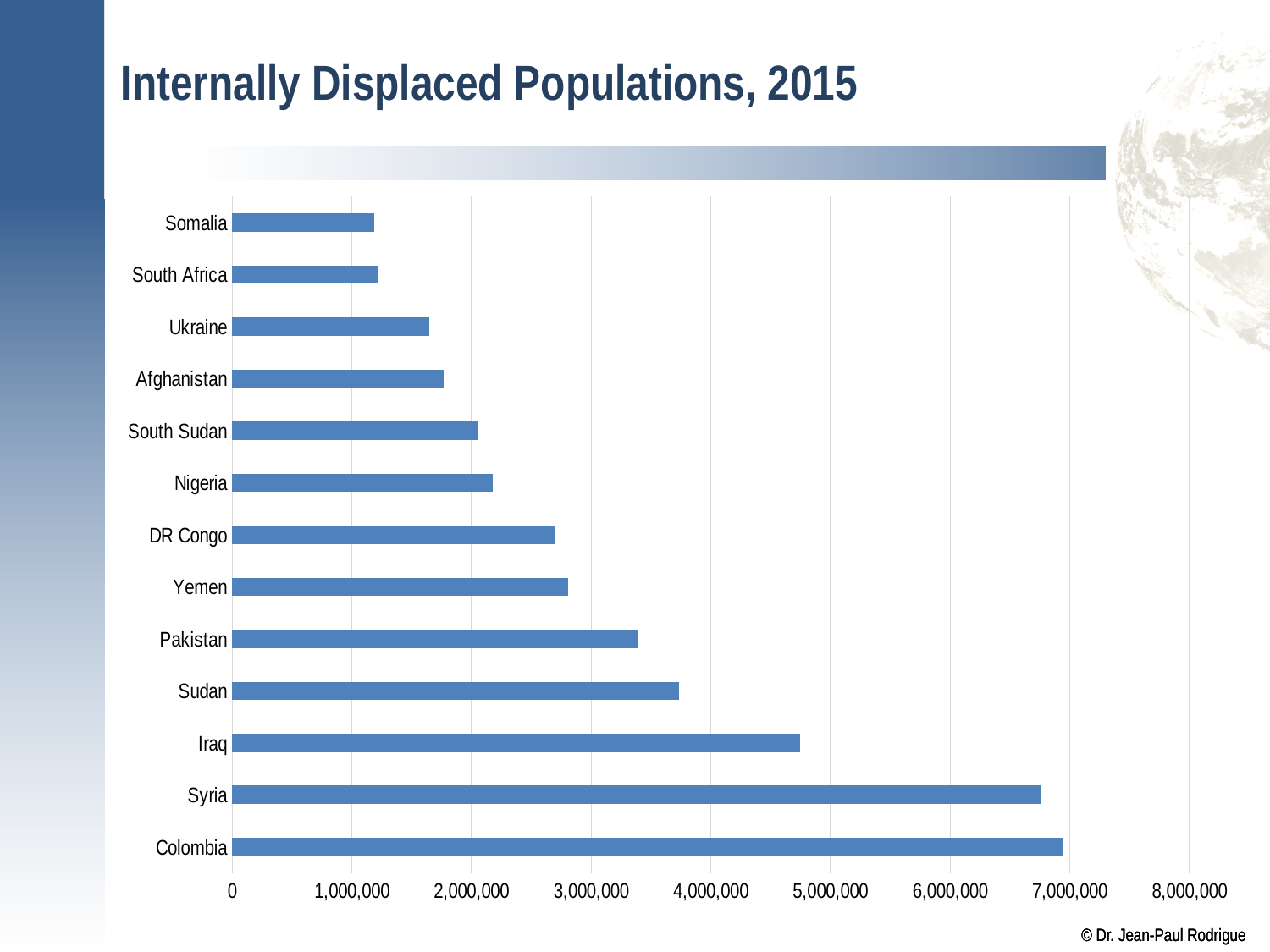
Is the value for Syria greater or less than 6,000,000? greater Is the value for Pakistan greater or less than 3,000,000? greater Which country has the largest internally displaced population in the chart? Colombia Is the value for Sudan greater or less than 4,000,000? less How many countries are shown in the chart? 13 Which has a larger internally displaced population, Pakistan or Yemen? Pakistan What type of chart is shown on the slide? bar chart What is the highest value shown on the horizontal axis? 8,000,000 What is the title of the chart? Internally Displaced Populations, 2015 Which has a larger internally displaced population, Iraq or Sudan? Iraq